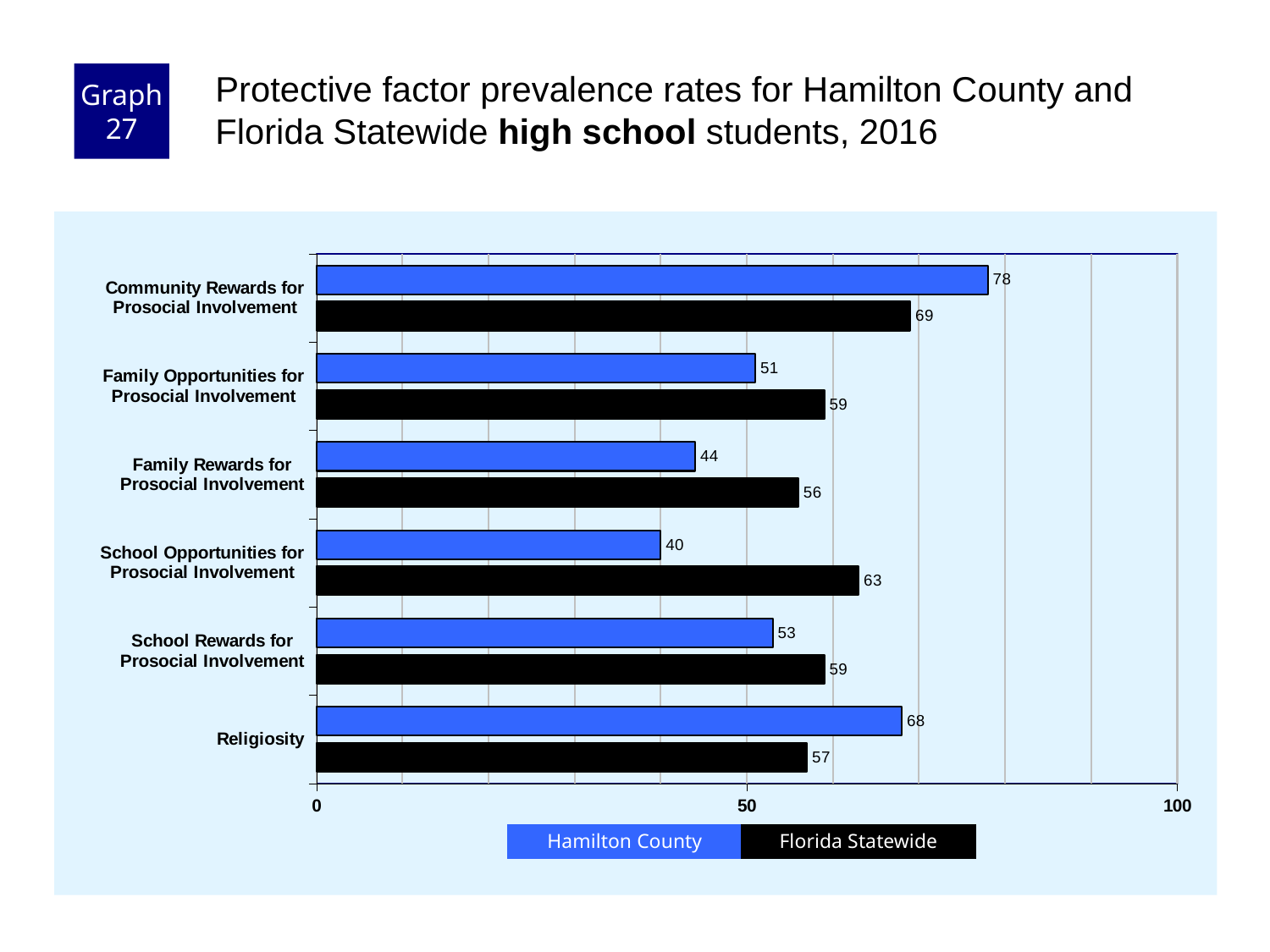
How many series does the legend list? 2 What is the Hamilton County value for Religiosity? 68 Which category has the highest Hamilton County value? Community Rewards for Prosocial Involvement What is the Florida Statewide value for School Opportunities for Prosocial Involvement? 63 Is the Hamilton County value for Family Rewards for Prosocial Involvement greater or less than 50? less What kind of chart is shown on the slide? Bar chart What is the Hamilton County value for Community Rewards for Prosocial Involvement? 78 Which category has the lowest Hamilton County value? School Opportunities for Prosocial Involvement For Religiosity, which is larger: Hamilton County or Florida Statewide? Hamilton County What is the difference between the Florida Statewide and Hamilton County values for School Opportunities for Prosocial Involvement? 23 How many categories are shown on the chart? 6 Which category has the lowest Florida Statewide value? Family Rewards for Prosocial Involvement